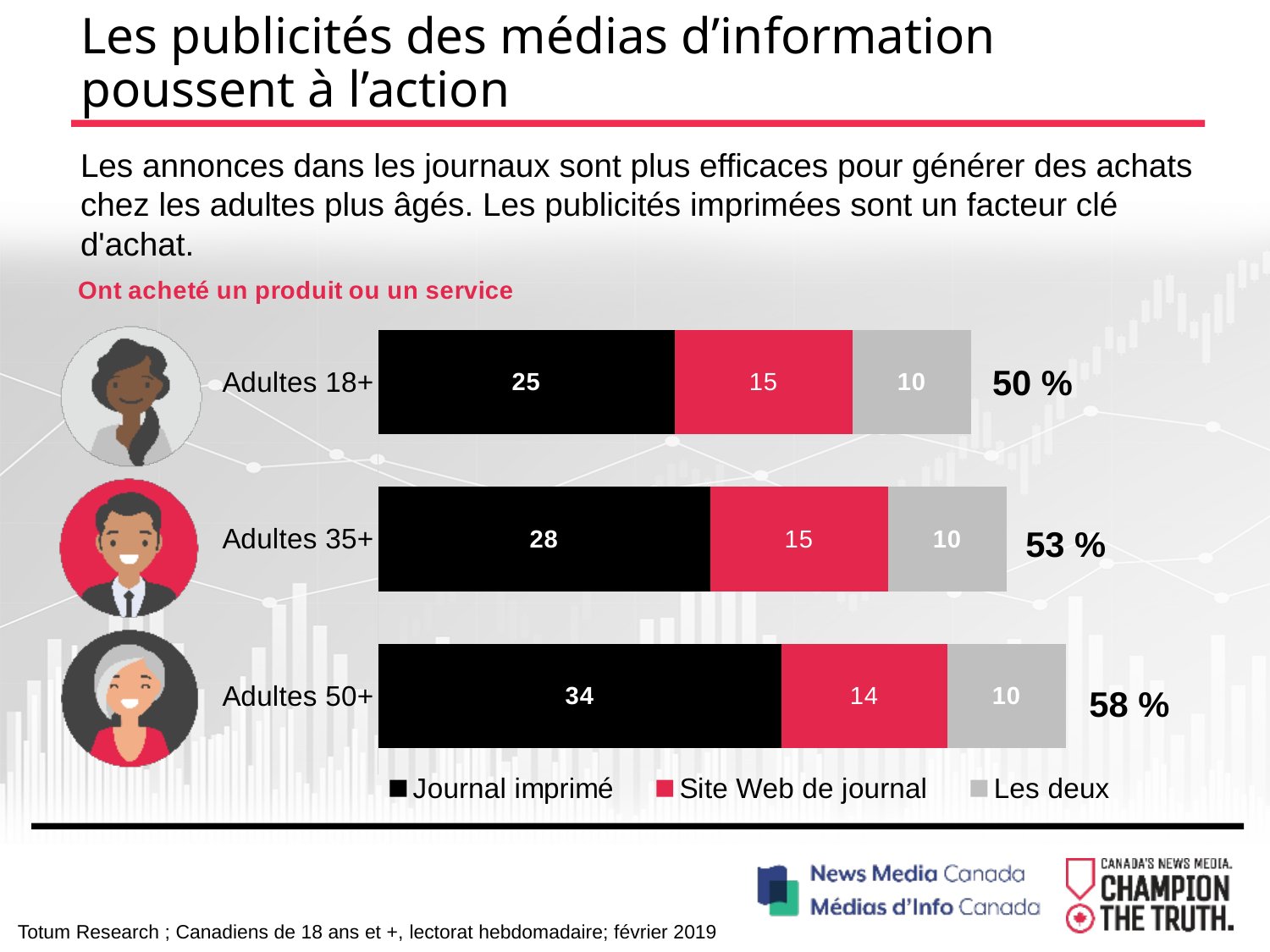
Which age group has the lowest value for Journal imprimé? Adultes 18+ What is the value for Journal imprimé for Adultes 50+? 34 Which age group has the highest value for Journal imprimé? Adultes 50+ How many series does the legend list? 3 What is the total shown for the Adultes 18+ bar? 50 % How many age groups are shown in the chart? 3 What is the value for Site Web de journal for Adultes 18+? 15 Which is larger: the Journal imprimé value for Adultes 35+ or for Adultes 18+? Adultes 35+ What is the total shown for the Adultes 50+ bar? 58 % What is the value for Les deux for Adultes 35+? 10 What kind of chart is shown on the slide? Stacked bar chart What is the difference between the Journal imprimé values for Adultes 50+ and Adultes 18+? 9